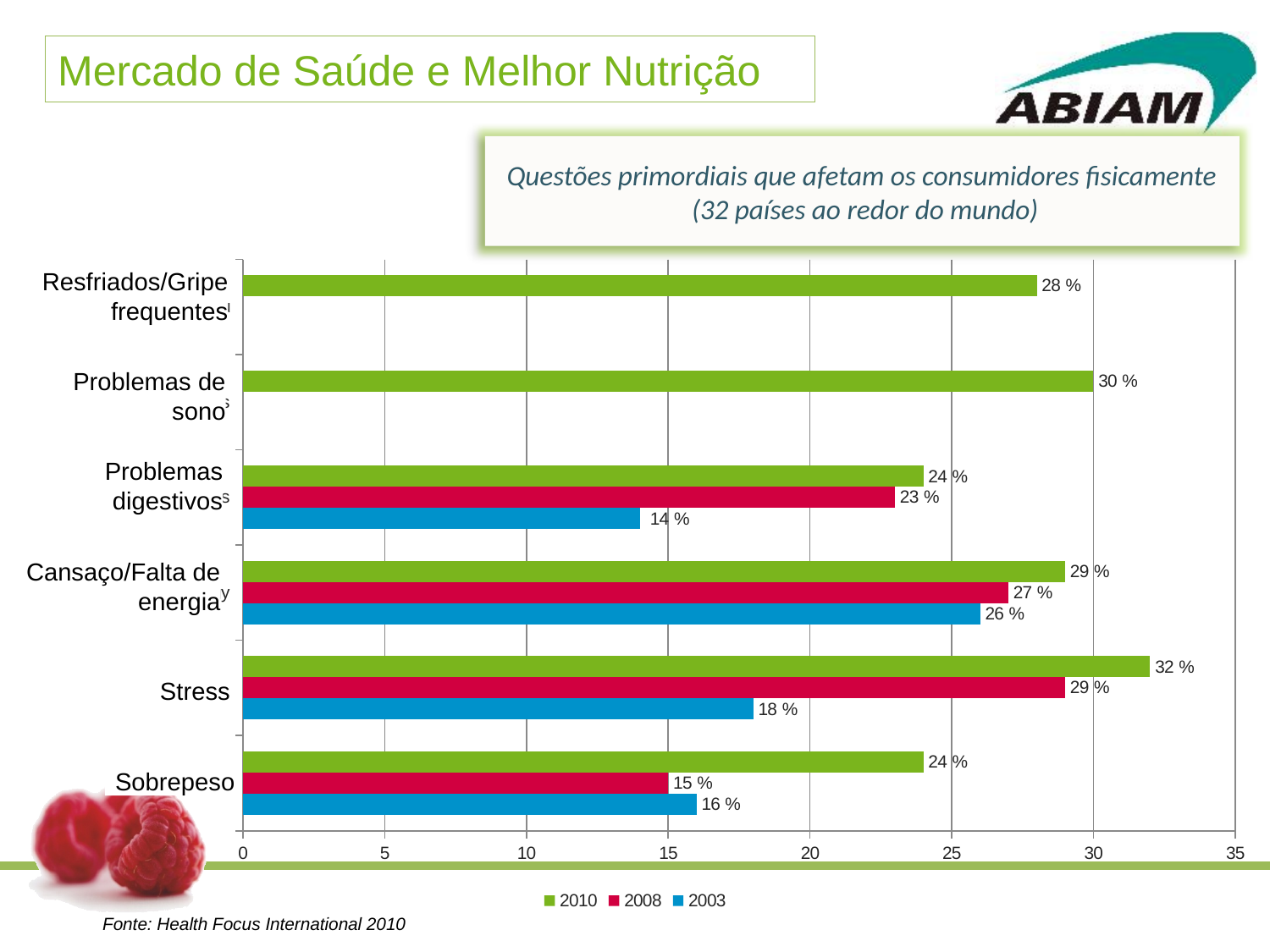
How many categories are shown on the chart? 6 What is the 2010 value for Stress? 32 % Which is larger for Sobrepeso, the 2008 value or the 2003 value? 2003 Which category has the lowest 2003 value? Problemas digestivos How many series does the legend list? 3 What is the 2010 value for Problemas de sono? 30 % What is the 2008 value for Sobrepeso? 15 % Which category has the highest 2010 value? Stress What kind of chart is shown on the slide? Bar chart Which colour represents the 2003 series in the legend? Blue What is the difference between the 2010 and 2003 values for Stress? 14 % What is the 2003 value for Problemas digestivos? 14 %